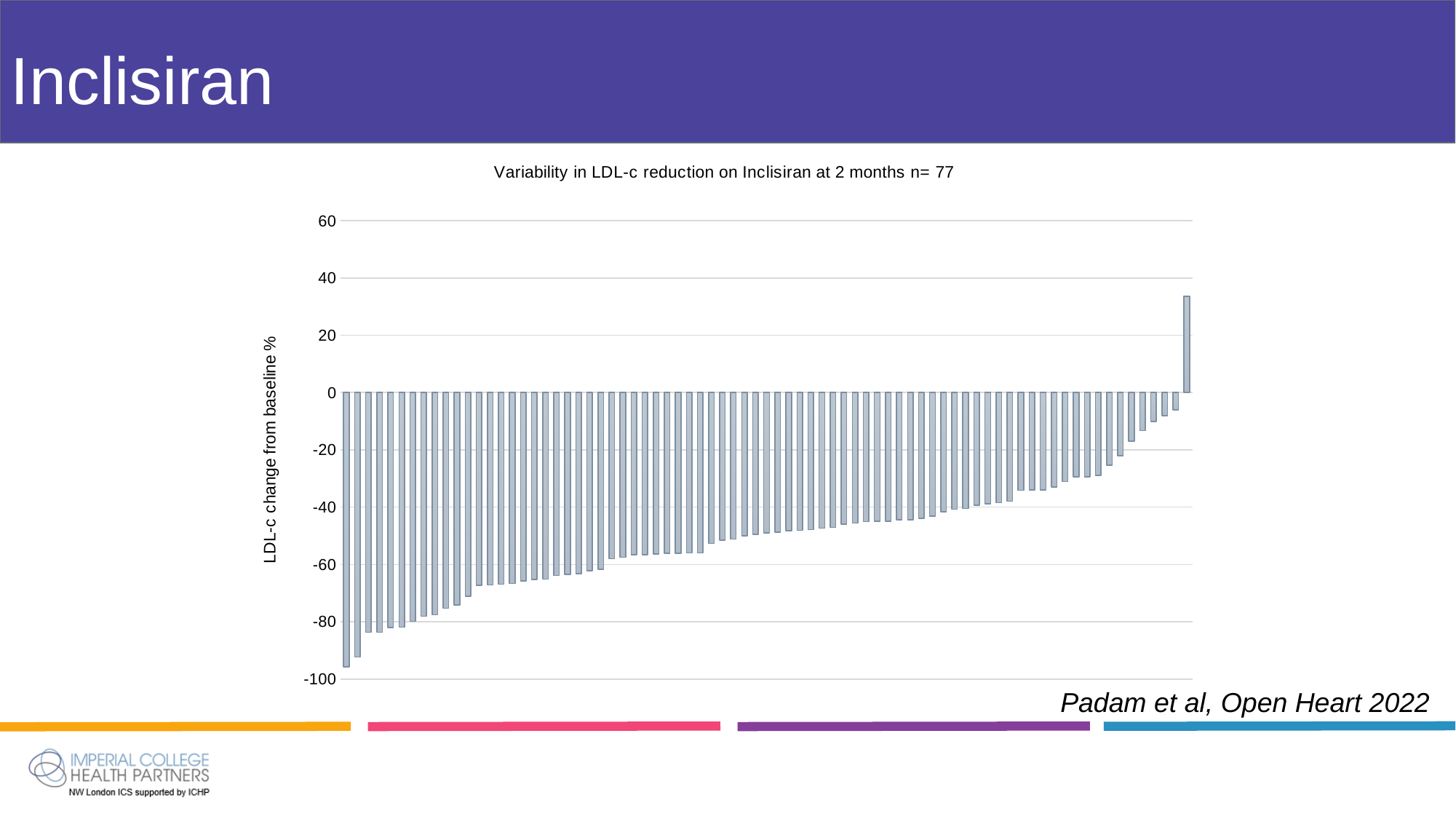
Which bar has the highest value, the leftmost bar or the rightmost bar? the rightmost bar How many bars on the chart show a positive LDL-c change from baseline? 1 Is the value of the leftmost bar greater or less than -80? less Is the value of the rightmost bar greater or less than 20? greater Which bar has the lowest value, the leftmost bar or the rightmost bar? the leftmost bar According to the chart title, how many patients (n) are included? 77 What kind of chart is shown on the slide? bar chart Is the value of the rightmost bar greater or less than 40? less What is the title of the chart? Variability in LDL-c reduction on Inclisiran at 2 months n= 77 Do the bar values rise or fall moving from left to right along the x axis? rise What is the lowest value shown on the vertical axis of the chart? -100 What is the label on the vertical axis of the chart? LDL-c change from baseline %